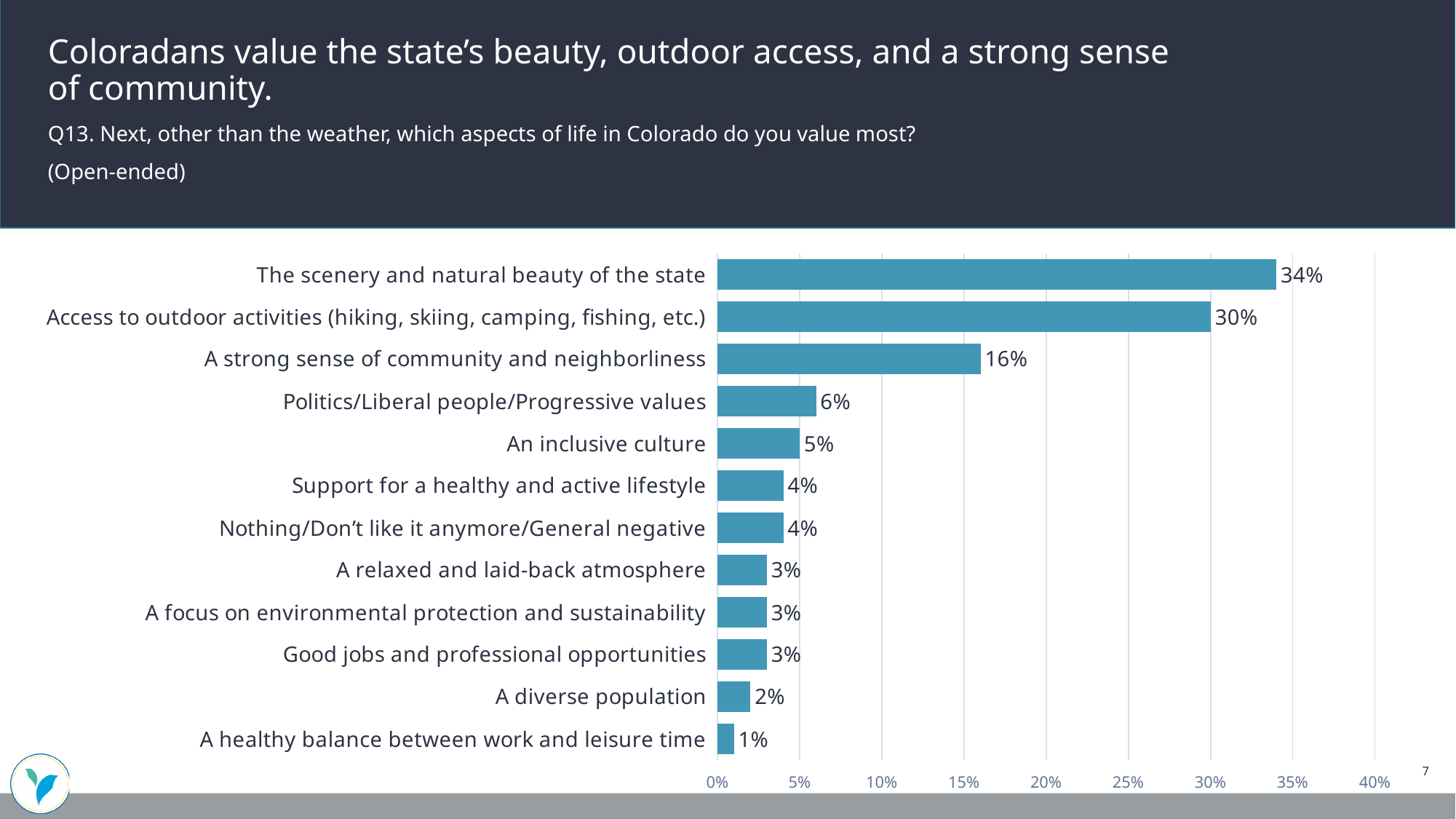
What kind of chart is shown on the slide? Bar chart Which category has the lowest value? A healthy balance between work and leisure time What is the value for 'A strong sense of community and neighborliness'? 16% What is the difference between the values for 'The scenery and natural beauty of the state' and 'Access to outdoor activities (hiking, skiing, camping, fishing, etc.)'? 4% What percentage is shown for 'An inclusive culture'? 5% What is the maximum value shown on the horizontal axis? 40% How many categories are shown in the chart? 12 Is the value for 'A strong sense of community and neighborliness' greater or less than 20%? less Which is larger: the value for 'Politics/Liberal people/Progressive values' or 'A diverse population'? Politics/Liberal people/Progressive values What is the difference between 'Access to outdoor activities' and 'A strong sense of community and neighborliness'? 14% What percentage of respondents value the scenery and natural beauty of the state? 34% Which category has the highest value? The scenery and natural beauty of the state